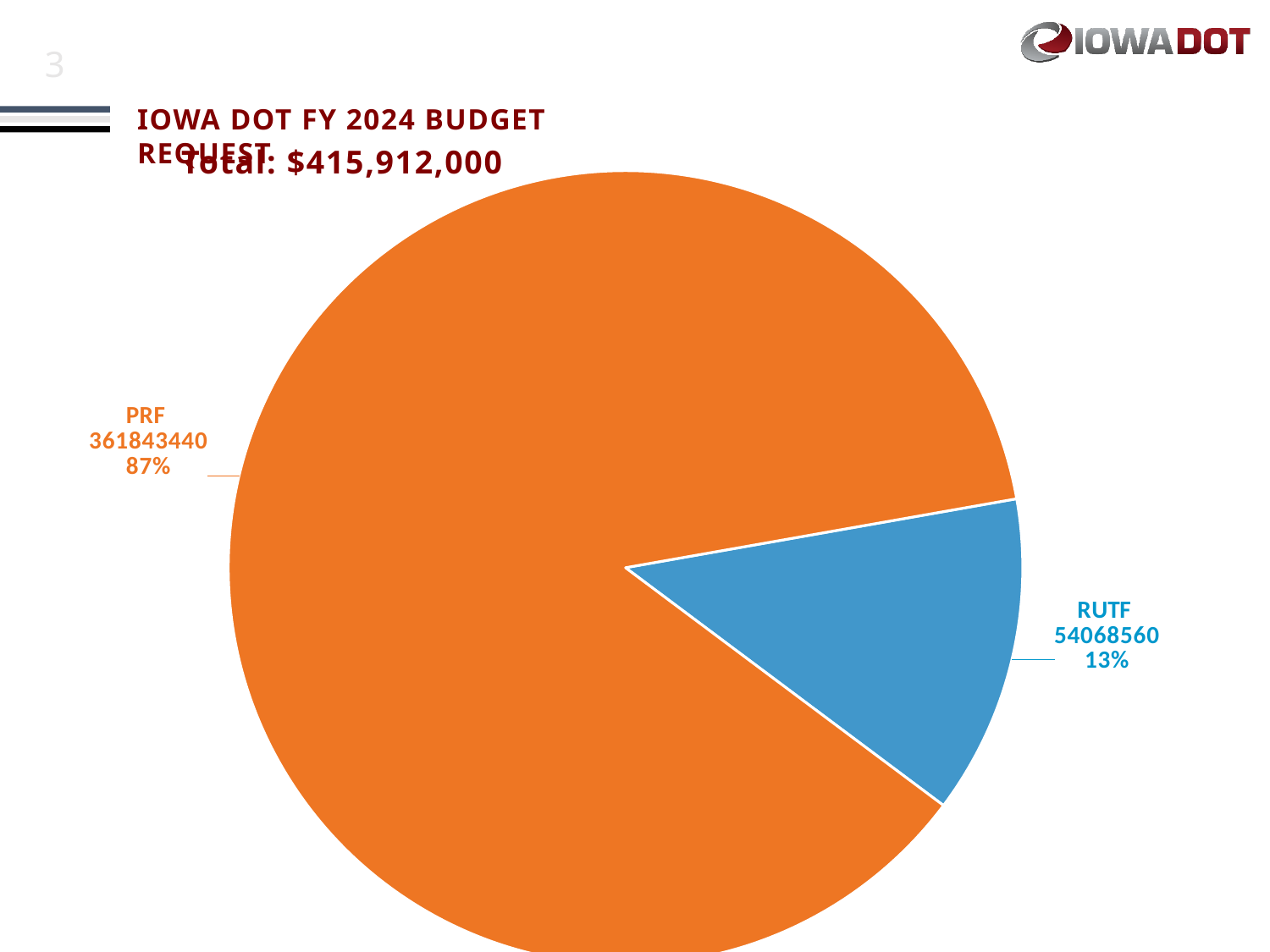
Which slice is the smallest? RUTF What share of the pie does RUTF represent? 13% What is the value for RUTF? 54068560 What is the difference between the PRF and RUTF values? 307774880 Which slice is the largest? PRF How many slices does the pie chart have? 2 What colour is the RUTF slice? blue What type of chart is shown on the slide? pie chart What is the value for PRF? 361843440 Which is larger, PRF or RUTF? PRF What total is stated in the chart title? $415,912,000 What share of the pie does PRF represent? 87%